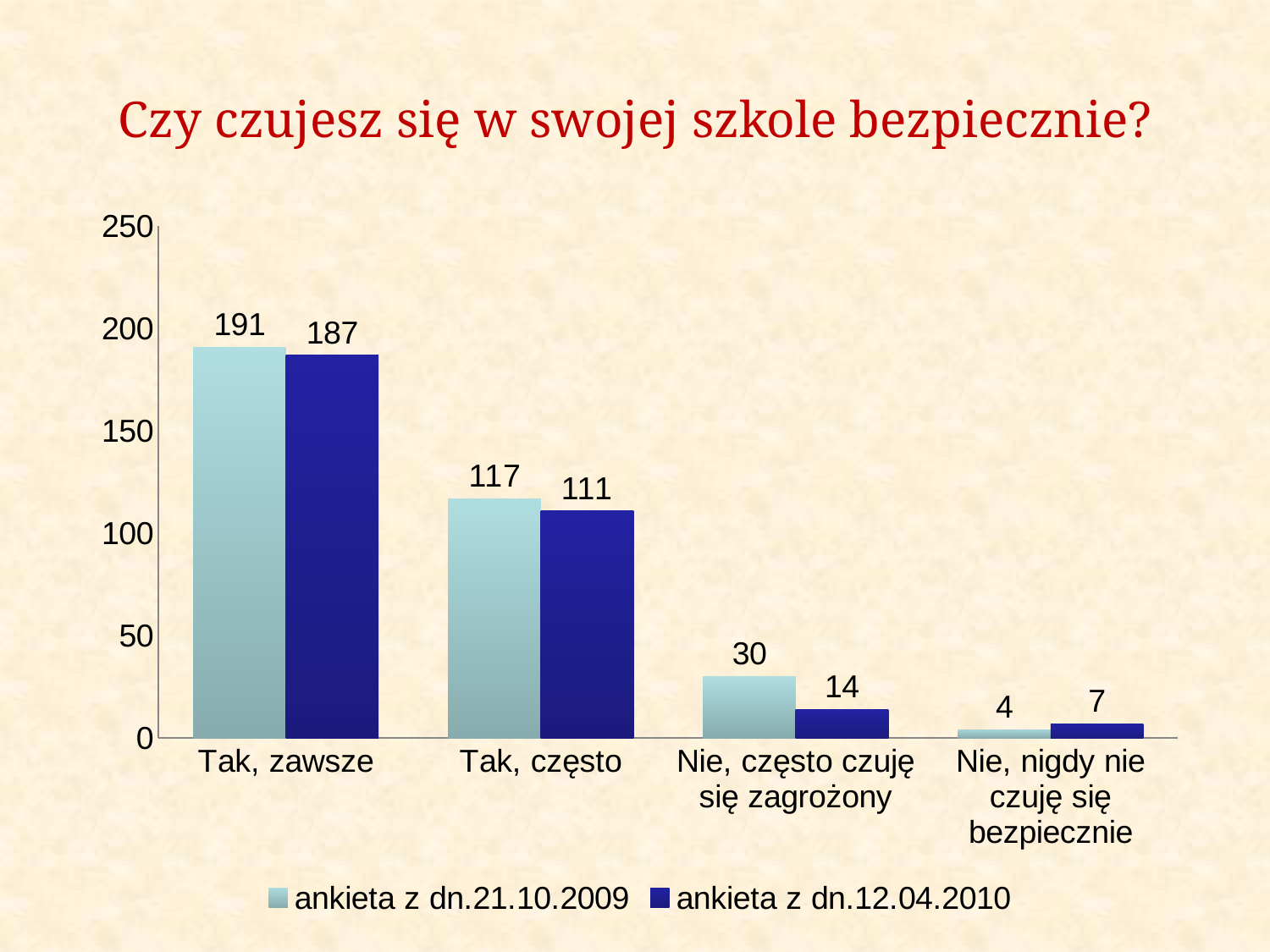
What kind of chart is shown on the slide? Bar chart For "Nie, nigdy nie czuję się bezpiecznie", which series has the larger value? ankieta z dn.12.04.2010 What is the difference between the two series for "Nie, często czuję się zagrożony"? 16 What is the value for "Nie, nigdy nie czuję się bezpiecznie" in the "ankieta z dn.12.04.2010" series? 7 How many categories are shown on the x axis? 4 What is the value for "Nie, często czuję się zagrożony" in the "ankieta z dn.21.10.2009" series? 30 What is the difference between the "ankieta z dn.21.10.2009" and "ankieta z dn.12.04.2010" values for "Tak, zawsze"? 4 What is the value for "Tak, zawsze" in the "ankieta z dn.21.10.2009" series? 191 What is the value for "Tak, często" in the "ankieta z dn.12.04.2010" series? 111 Which category has the lowest value in the "ankieta z dn.21.10.2009" series? Nie, nigdy nie czuję się bezpiecznie Which category has the highest value in the "ankieta z dn.12.04.2010" series? Tak, zawsze How many series does the legend list? 2